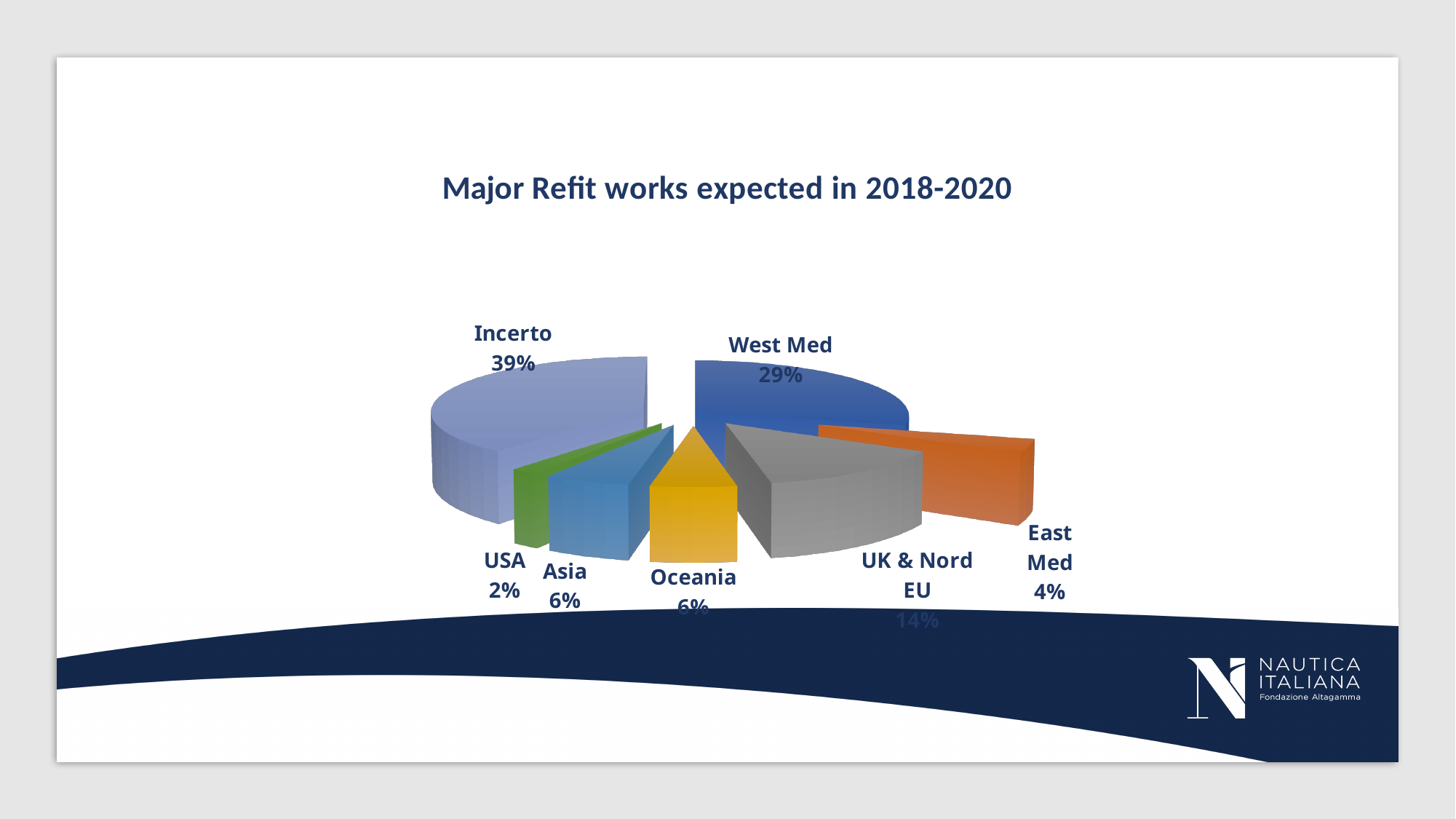
Which category has the smallest share of the pie? USA What type of chart is shown on the slide? Pie chart What share does East Med have in the pie chart? 4% What share does USA have in the pie chart? 2% What is the difference in percentage points between Incerto and West Med? 10 Which category has the largest share of the pie? Incerto What share does Incerto have in the pie chart? 39% What share does UK & Nord EU have in the pie chart? 14% What is the title of the chart? Major Refit works expected in 2018-2020 What share does West Med have in the pie chart? 29% Which is larger, the share for UK & Nord EU or the share for Asia? UK & Nord EU How many categories are shown in the pie chart? 7